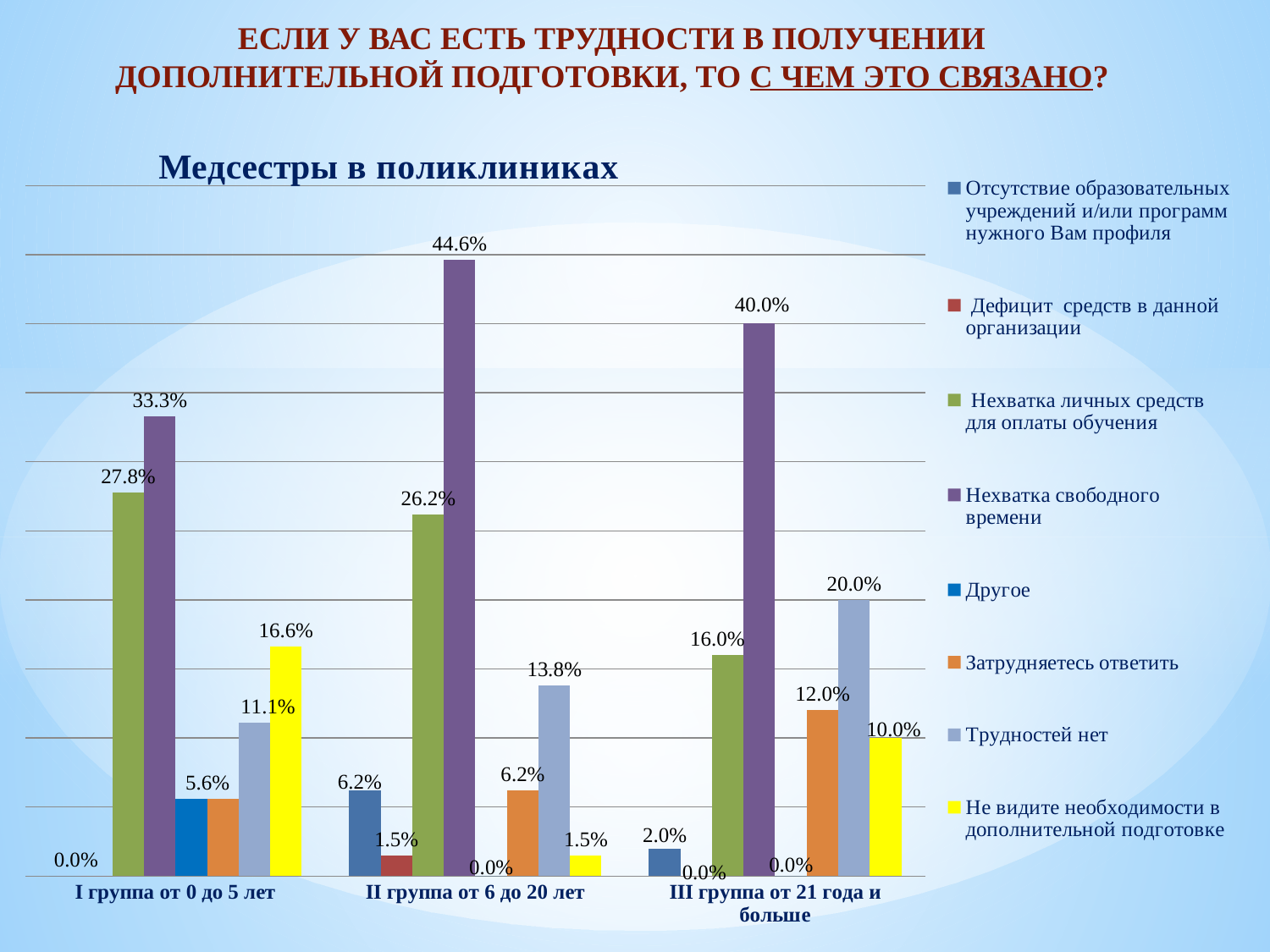
What is the value for «Трудностей нет» in «III группа от 21 года и больше»? 20.0% What kind of chart is shown on the slide? Bar chart How many groups (categories) are shown along the x axis? 3 In which group is the value for «Нехватка свободного времени» the highest? II группа от 6 до 20 лет What is the difference between the «Нехватка свободного времени» values for «II группа от 6 до 20 лет» and «III группа от 21 года и больше»? 4.6 percentage points How many series does the legend list? 8 What is the value for «Нехватка личных средств для оплаты обучения» in «I группа от 0 до 5 лет»? 27.8% What is the value for «Затрудняетесь ответить» in «III группа от 21 года и больше»? 12.0% What is the value for «Нехватка свободного времени» in «II группа от 6 до 20 лет»? 44.6% Does the value for «Нехватка личных средств для оплаты обучения» rise or fall from «I группа» to «III группа»? Falls What is the value for «Не видите необходимости в дополнительной подготовке» in «I группа от 0 до 5 лет»? 16.6% What is the title of the chart? Медсестры в поликлиниках